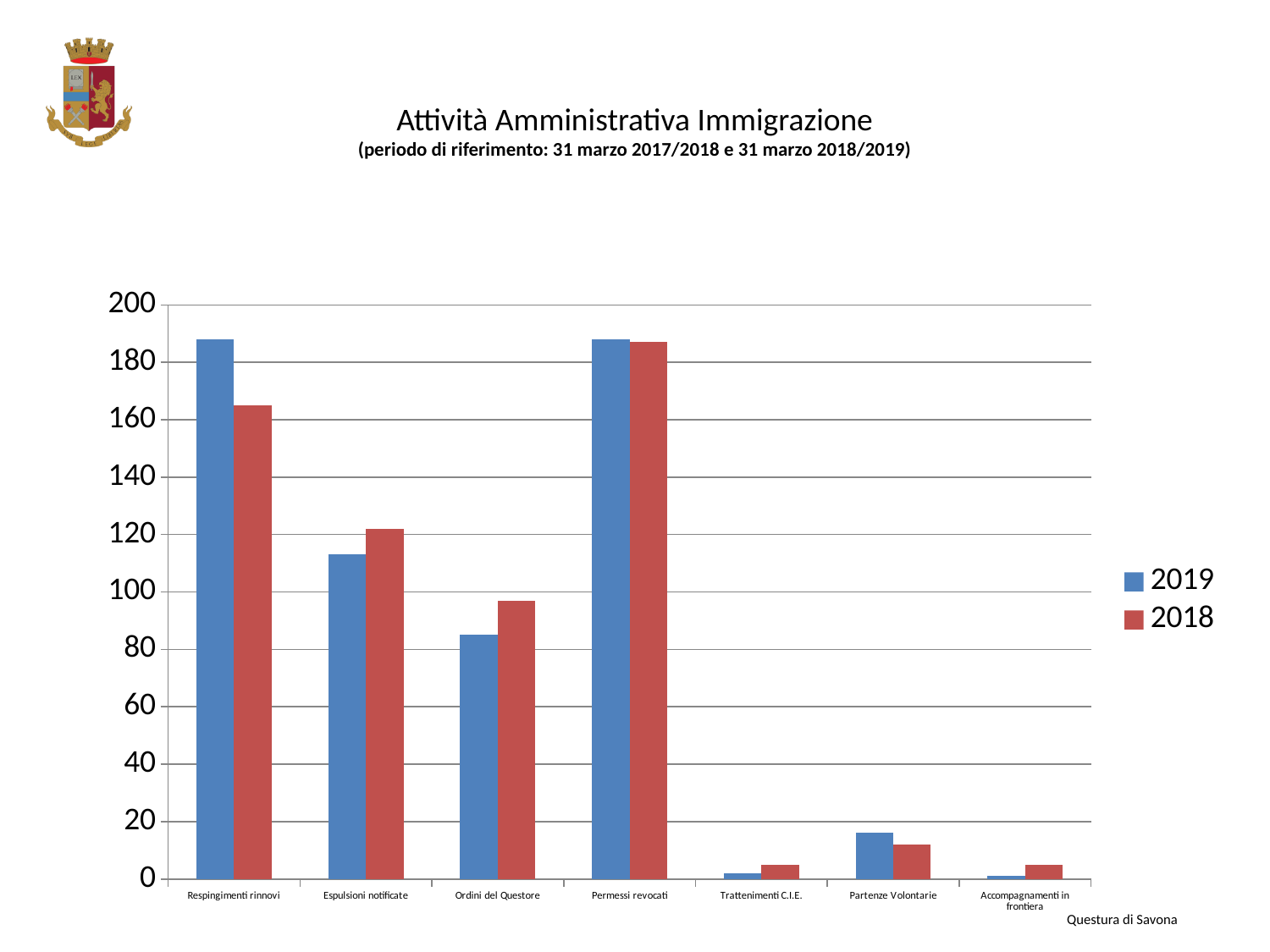
What kind of chart is shown on the slide? bar chart Which series has the higher value for Partenze Volontarie, 2019 or 2018? 2019 Which series has the higher value for Espulsioni notificate, 2019 or 2018? 2018 Which series has the higher value for Ordini del Questore, 2019 or 2018? 2018 How many categories are shown on the x axis? 7 How many series does the legend list? 2 Is the 2019 value for Respingimenti rinnovi greater or less than 180? greater Is the 2018 value for Respingimenti rinnovi greater or less than 180? less Is the 2019 value for Espulsioni notificate greater or less than 100? greater Which category has the highest value for the 2018 series? Permessi revocati